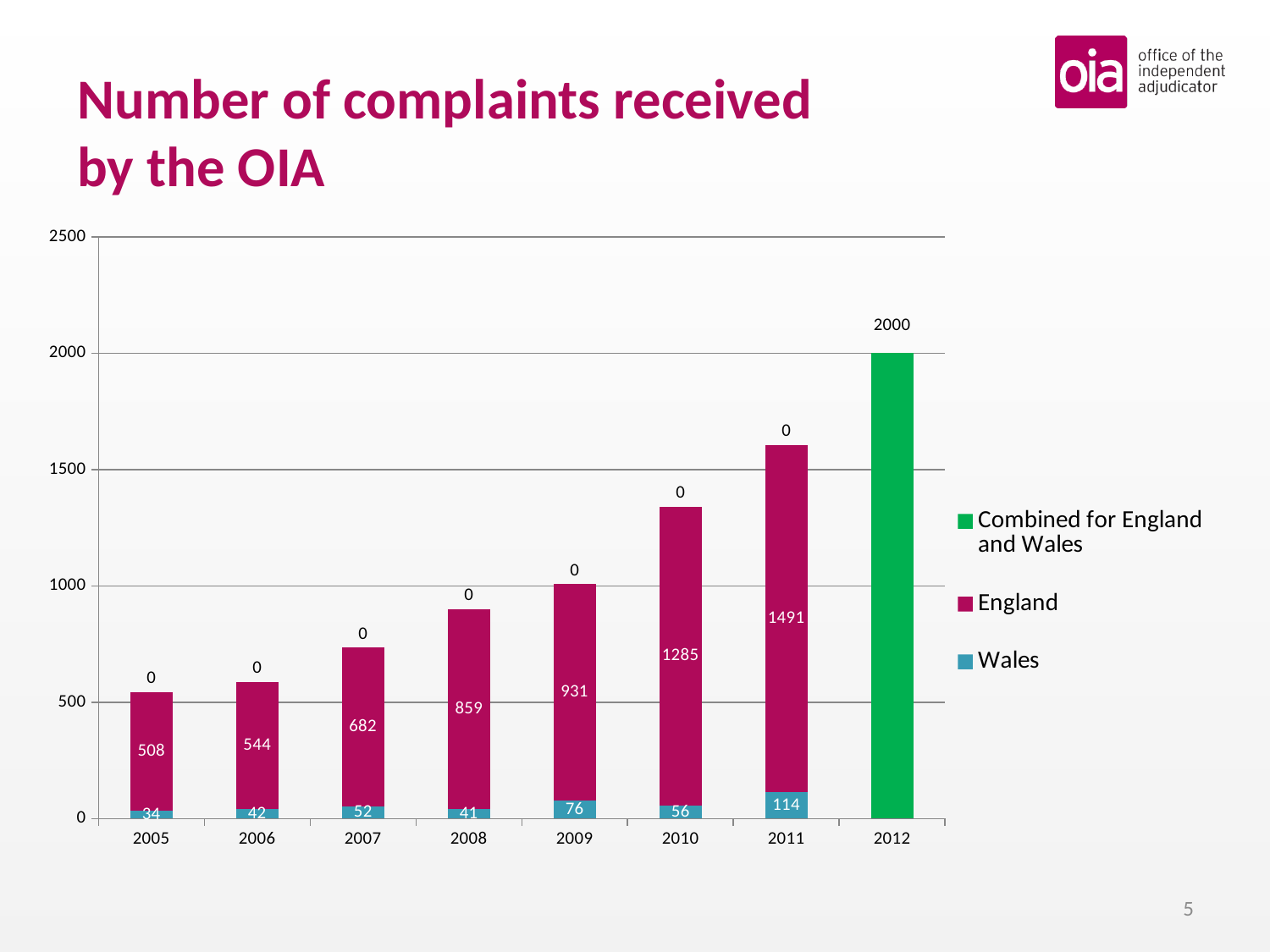
How many years are shown on the x axis? 8 What is the Wales value for 2009? 76 What is the total of the stacked bar for 2011? 1605 Which year has the lowest England value? 2005 What is the difference between the England values for 2011 and 2010? 206 What kind of chart is shown? stacked bar chart What is the value for Combined for England and Wales in 2012? 2000 How many series does the legend list? 3 Which year has the highest Wales value? 2011 Which is larger, the Wales value for 2007 or for 2008? 2007 What is the England value for 2010? 1285 Is the total for 2009 greater or less than 1000? greater